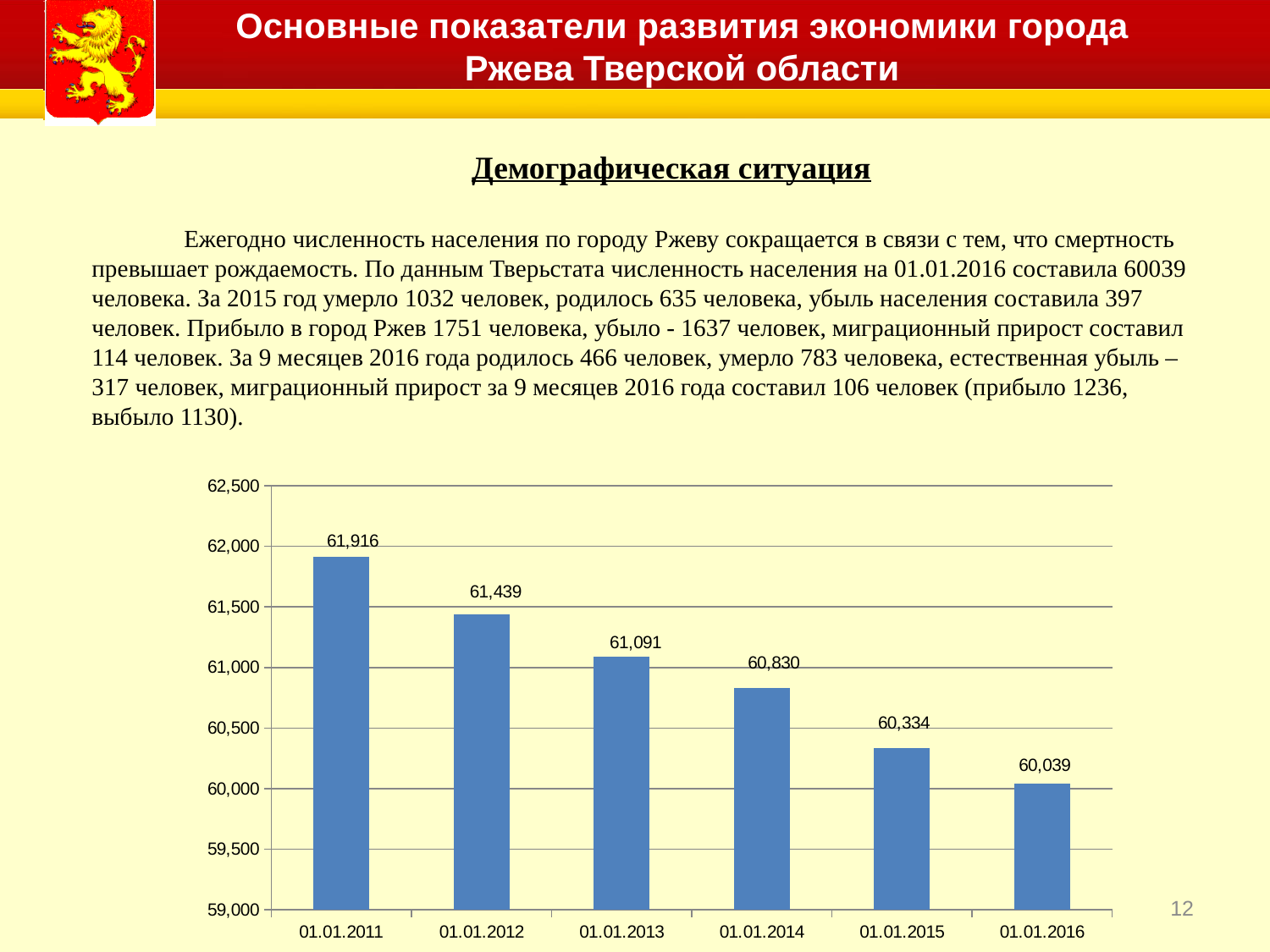
What is the value for 01.01.2014? 60,830 Do the values rise or fall from 01.01.2011 to 01.01.2016? fall What is the value for 01.01.2011? 61,916 What is the difference between the values for 01.01.2012 and 01.01.2013? 348 Which date has the lowest value? 01.01.2016 How many bars are shown in the chart? 6 What is the value for 01.01.2016? 60,039 Is the value for 01.01.2015 greater or less than 60,500? less What is the difference between the values for 01.01.2011 and 01.01.2016? 1,877 Which is larger, the value for 01.01.2013 or the value for 01.01.2015? 01.01.2013 What kind of chart is shown on the slide? bar chart Which date has the highest value? 01.01.2011